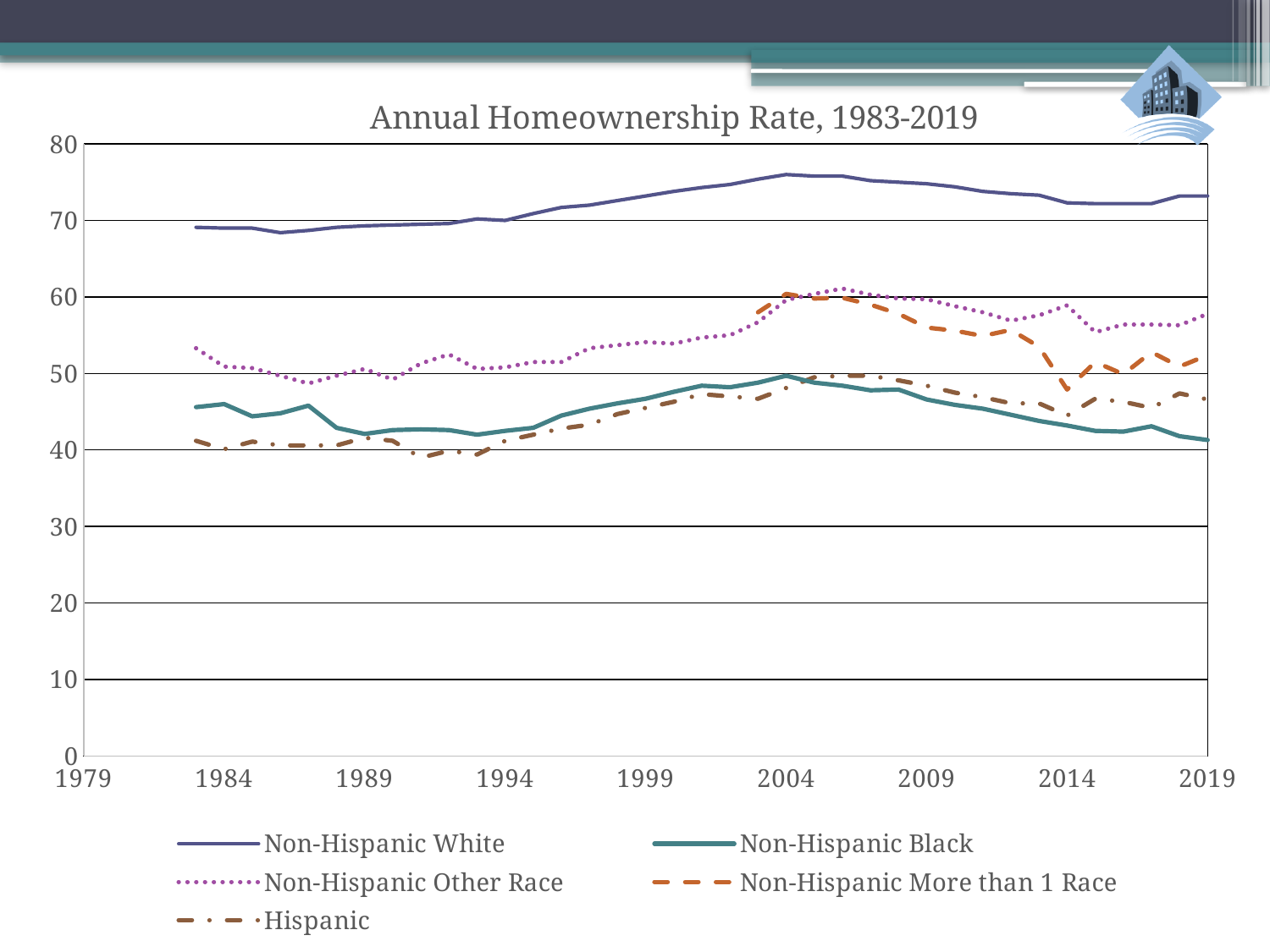
Which series is drawn with a dotted line? Non-Hispanic Other Race Does the Non-Hispanic Black series rise or fall from 2004 to 2019? fall What kind of chart is shown on the slide? line chart Which series has the highest homeownership rate across the whole period? Non-Hispanic White Is the value for Hispanic in 1984 greater or less than 50? less Is the value for Non-Hispanic Black in 2019 greater or less than 50? less Is the value for Non-Hispanic Other Race in 2004 greater or less than 50? greater How many series does the legend list? 5 What is the title of the chart? Annual Homeownership Rate, 1983-2019 Which series has the lowest homeownership rate in 2019? Non-Hispanic Black In 2019, which is larger: the value for Non-Hispanic Other Race or the value for Non-Hispanic Black? Non-Hispanic Other Race